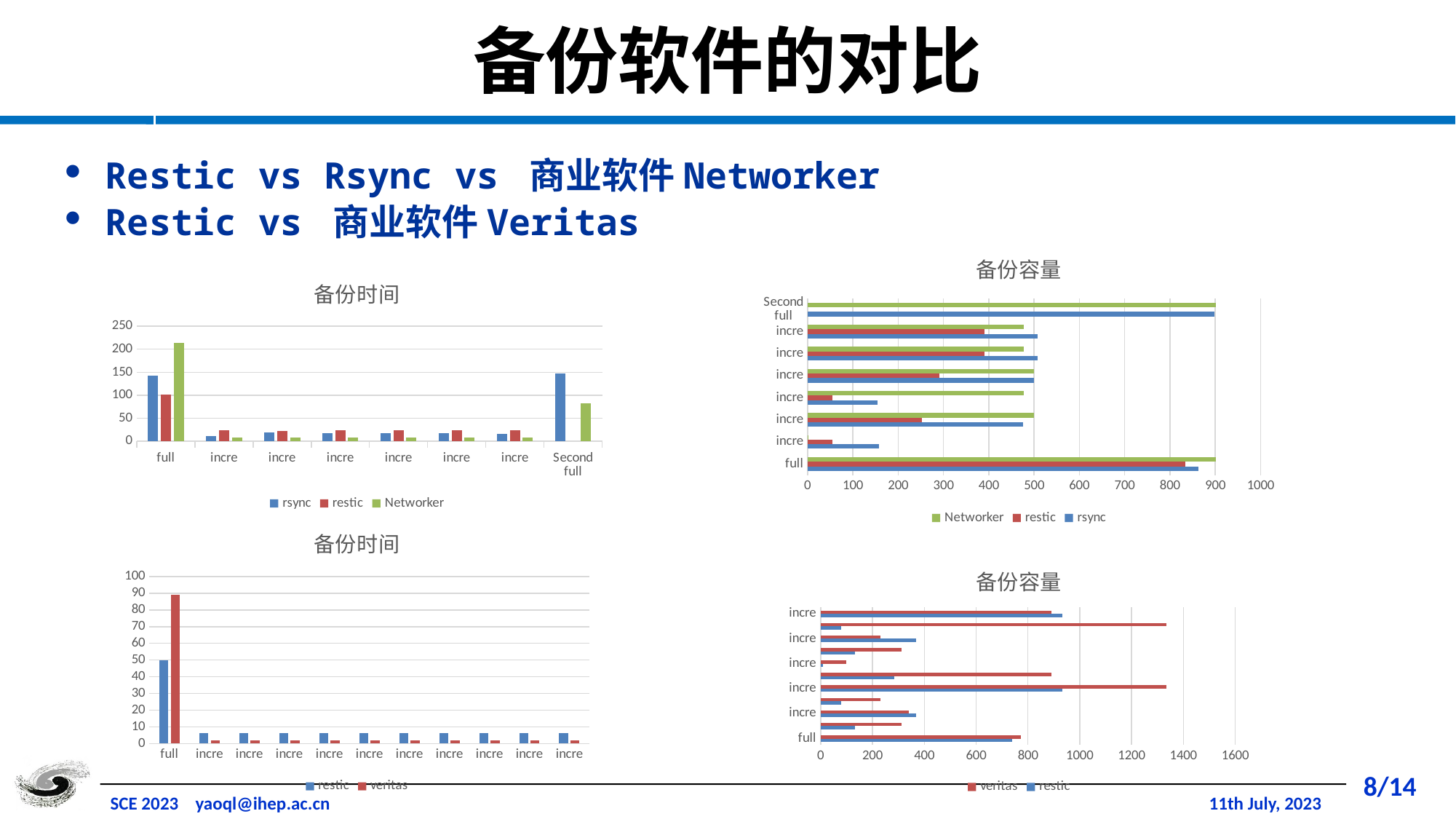
Which series does the legend of the top-right 备份容量 chart list first? Networker How many categories are shown on the x axis of the bottom-left 备份时间 chart? 11 What type of chart is the top-right chart titled 备份容量? bar chart In the top-left 备份时间 chart, is the Networker value for 'full' greater or less than 200? greater In the top-left 备份时间 chart, which series has the tallest bar for the 'full' category? Networker In the top-right 备份容量 chart, is the rsync value for 'Second full' greater or less than 800? greater In the bottom-left 备份时间 chart, which series has the taller bar for 'full': restic or veritas? veritas In the top-left 备份时间 chart, which is larger for 'Second full': rsync or Networker? rsync In the bottom-right 备份容量 chart, which series has the longer bar for 'full': veritas or restic? veritas What type of chart is the top-left chart titled 备份时间? bar chart How many series does the legend of the top-left 备份时间 chart list? 3 In the bottom-left 备份时间 chart, is the veritas value for 'full' greater or less than 80? greater